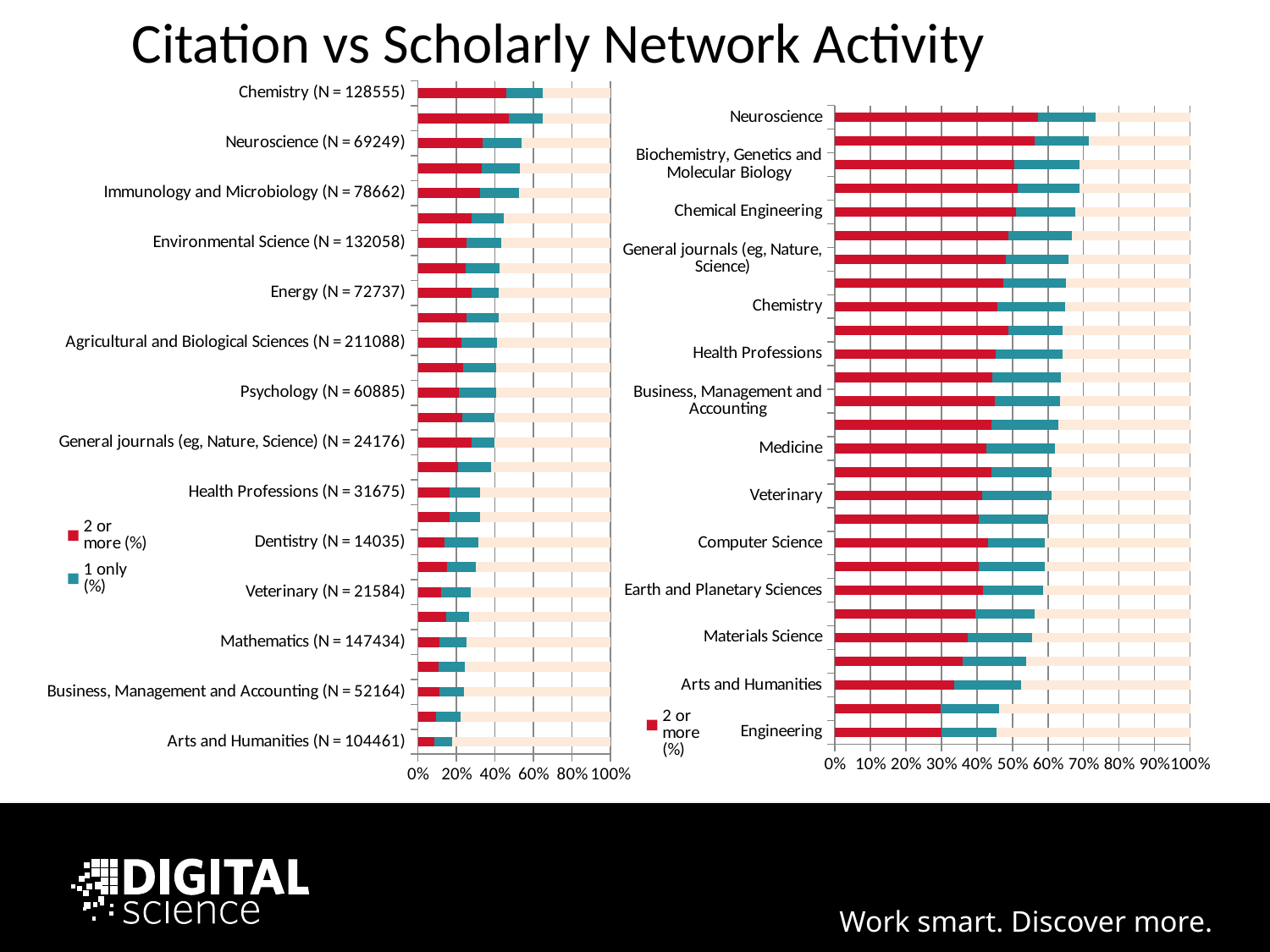
In the left chart, is the '2 or more (%)' value for Chemistry greater or less than 20%? greater In the left chart, is the '2 or more (%)' value for Arts and Humanities greater or less than 20%? less In the left chart, how many series does the legend list? 2 In the left chart, which labelled category has the lowest '2 or more (%)' value? Arts and Humanities (N = 104461) In the left chart, what are the two legend entries? 2 or more (%) and 1 only (%) In the right chart, is the '2 or more (%)' value for Engineering greater or less than 40%? less What is the title of the slide's charts? Citation vs Scholarly Network Activity In the right chart, which has the larger '2 or more (%)' value, Neuroscience or Engineering? Neuroscience What kind of chart is shown on the left of the slide? bar chart In the left chart, which labelled category has the highest '2 or more (%)' value? Chemistry (N = 128555) In the right chart, which category has the highest '2 or more (%)' value? Neuroscience